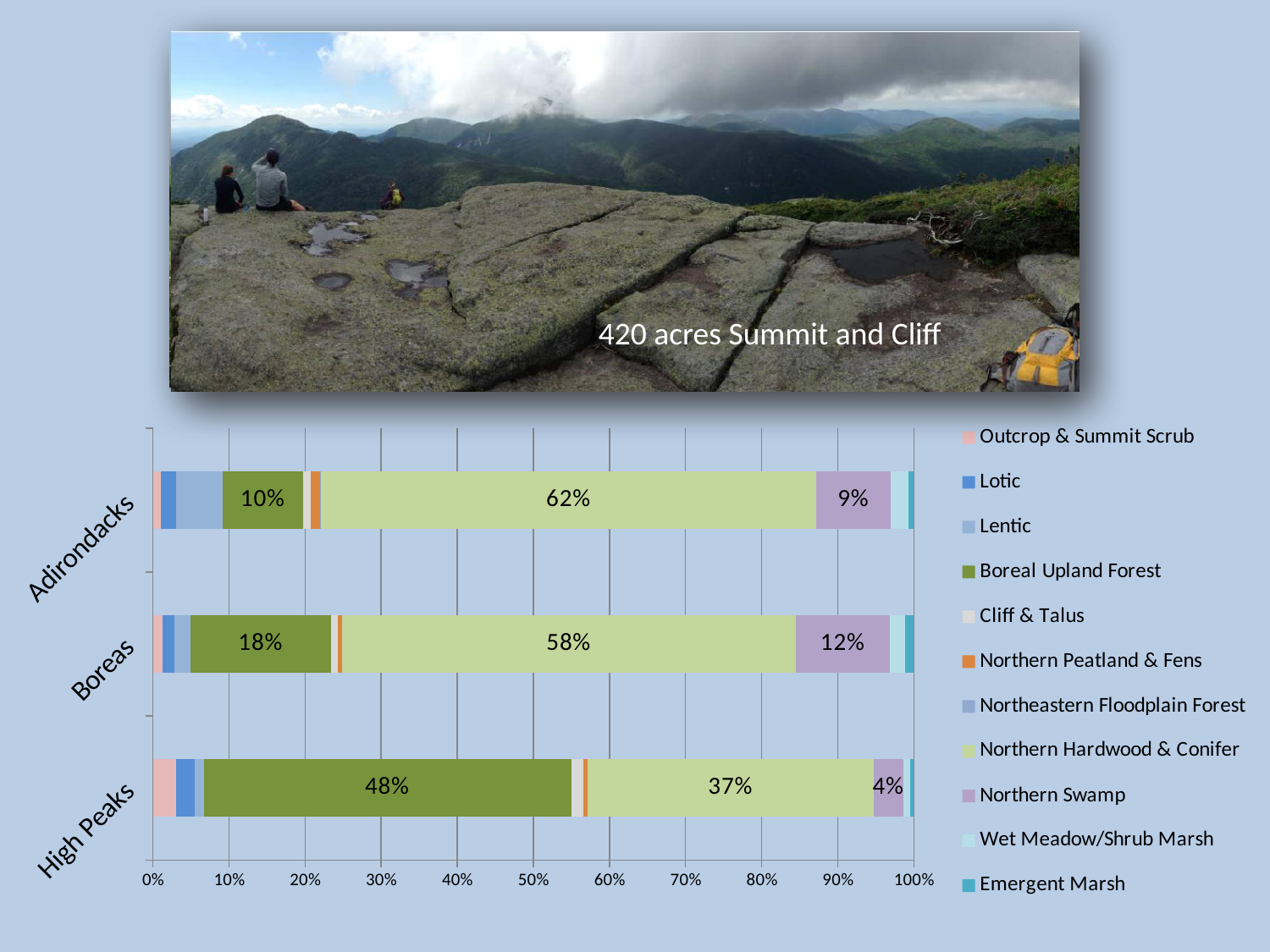
What is the Northern Hardwood & Conifer share for Adirondacks? 62% What kind of chart is shown on the slide? stacked bar chart What is the Boreal Upland Forest share for High Peaks? 48% What is the Northern Swamp share for Boreas? 12% Which is larger for High Peaks: the Boreal Upland Forest share or the Northern Hardwood & Conifer share? Boreal Upland Forest Which region has the highest Boreal Upland Forest share? High Peaks How many series does the chart legend list? 11 What is the difference between the Northern Hardwood & Conifer shares for Adirondacks and Boreas? 4% Which legend entry is shown in orange? Northern Peatland & Fens How many regions (categories) are plotted on the chart? 3 What is the Boreal Upland Forest share for Boreas? 18% Which region has the lowest Northern Swamp share? High Peaks